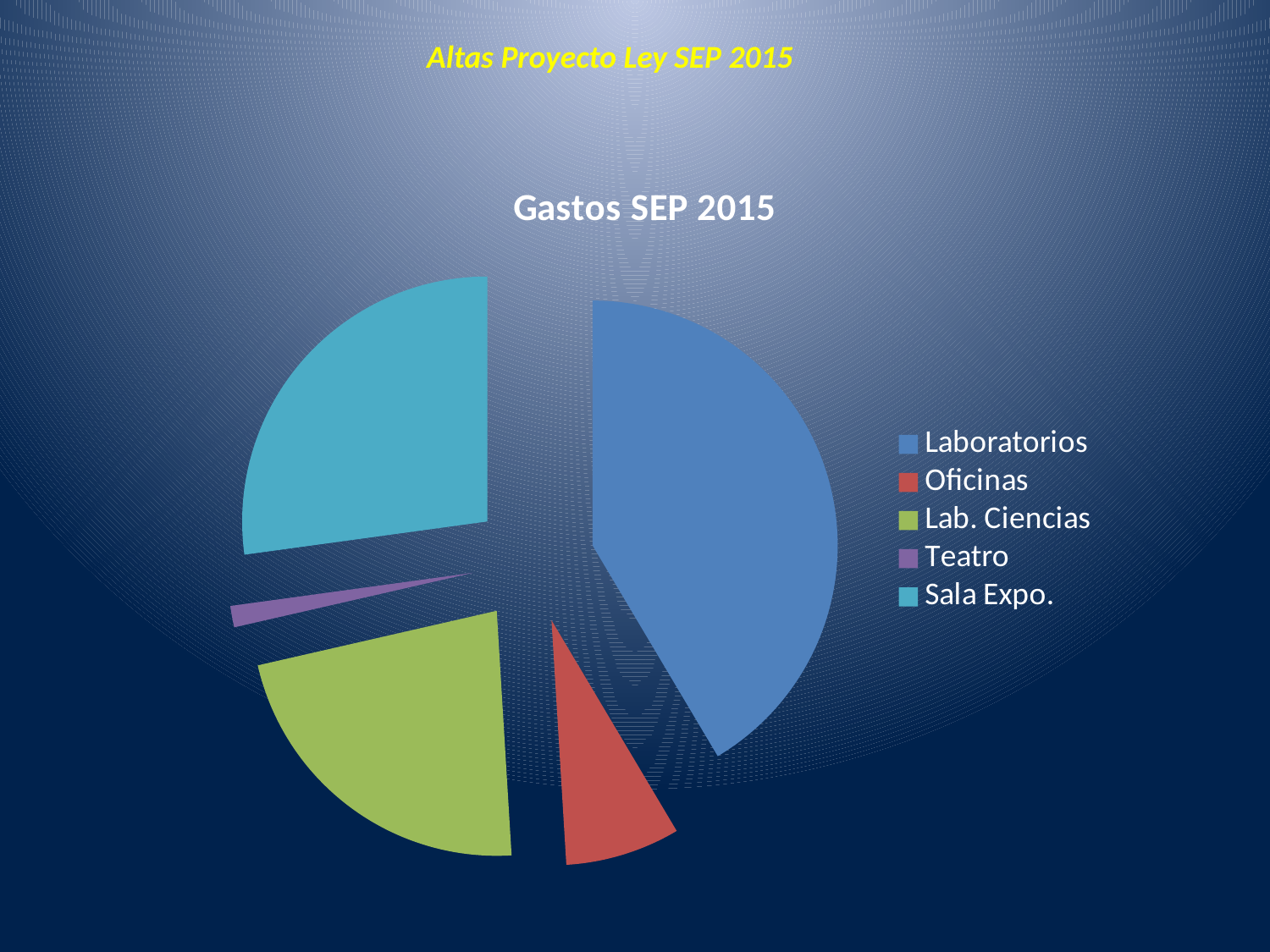
Which slice is larger, Sala Expo. or Oficinas? Sala Expo. Which slice is larger, Teatro or Oficinas? Oficinas What is the title of the chart? Gastos SEP 2015 Which slice is larger, Laboratorios or Sala Expo.? Laboratorios How many categories does the pie chart have? 5 What kind of chart is shown on the slide? pie chart How many entries does the legend list? 5 Which category has the largest slice of the pie? Laboratorios Which category is shown in red in the pie chart? Oficinas Which category has the smallest slice of the pie? Teatro